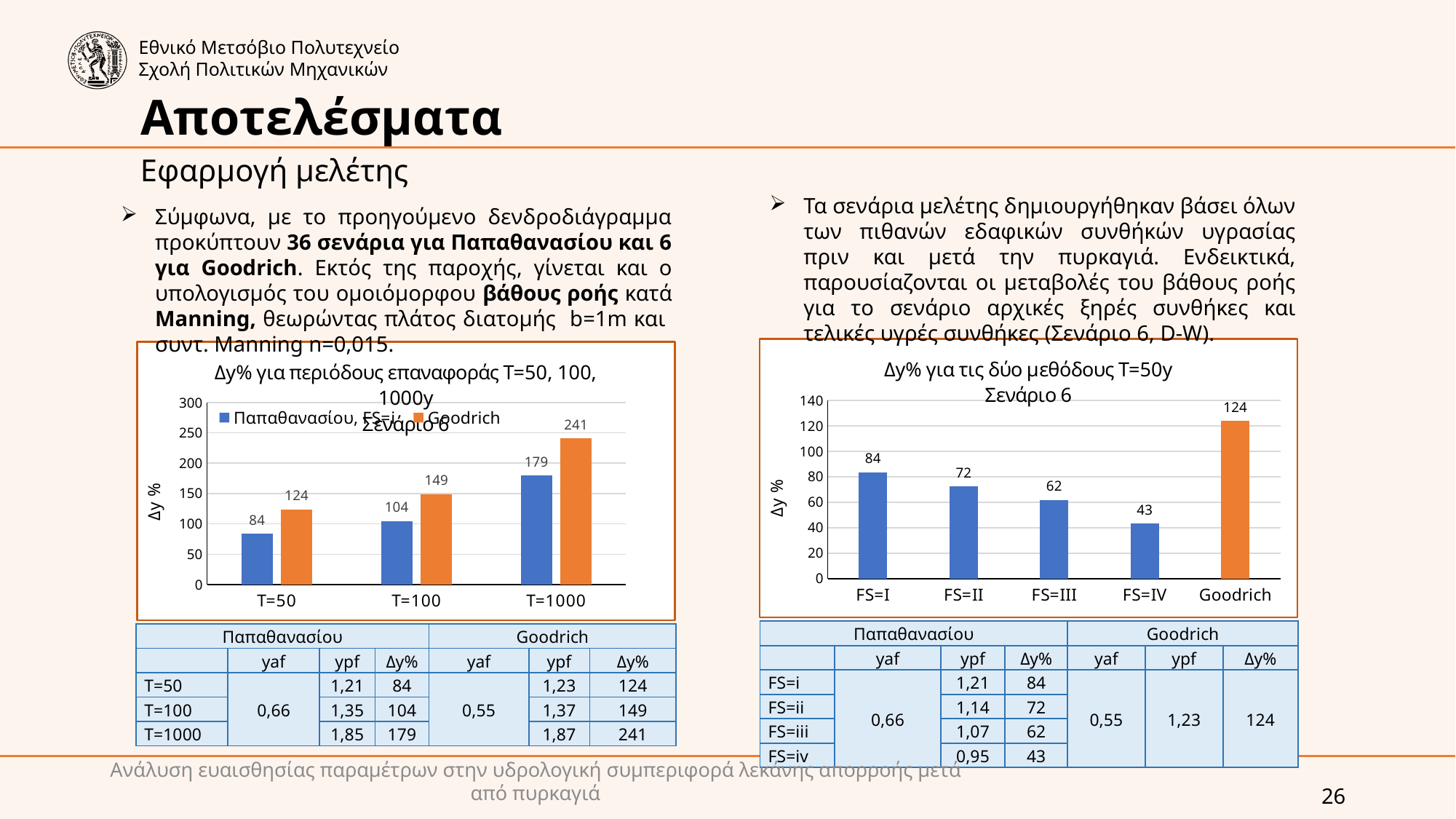
In the left chart (Δy% για περιόδους επαναφοράς), do the Παπαθανασίου values rise or fall from T=50 to T=1000? rise In the left chart (Δy% για περιόδους επαναφοράς), what is the Goodrich value for T=1000? 241 What kind of chart is the right chart (Δy% για τις δύο μεθόδους T=50y)? bar chart In the left chart (Δy% για περιόδους επαναφοράς), how many series does the legend list? 2 In the left chart (Δy% για περιόδους επαναφοράς), what is the Παπαθανασίου, FS=i value for T=100? 104 In the right chart (Δy% για τις δύο μεθόδους T=50y), what is the value for FS=III? 62 In the right chart (Δy% για τις δύο μεθόδους T=50y), which category has the lowest value? FS=IV In the left chart (Δy% για περιόδους επαναφοράς), what is the difference between the Goodrich and Παπαθανασίου values at T=50? 40 In the left chart (Δy% για περιόδους επαναφοράς), which series has the larger value at T=1000? Goodrich In the right chart (Δy% για τις δύο μεθόδους T=50y), what is the difference between the FS=I and FS=II values? 12 In the right chart (Δy% για τις δύο μεθόδους T=50y), which category has the highest value? Goodrich In the right chart (Δy% για τις δύο μεθόδους T=50y), how many categories are shown on the x axis? 5